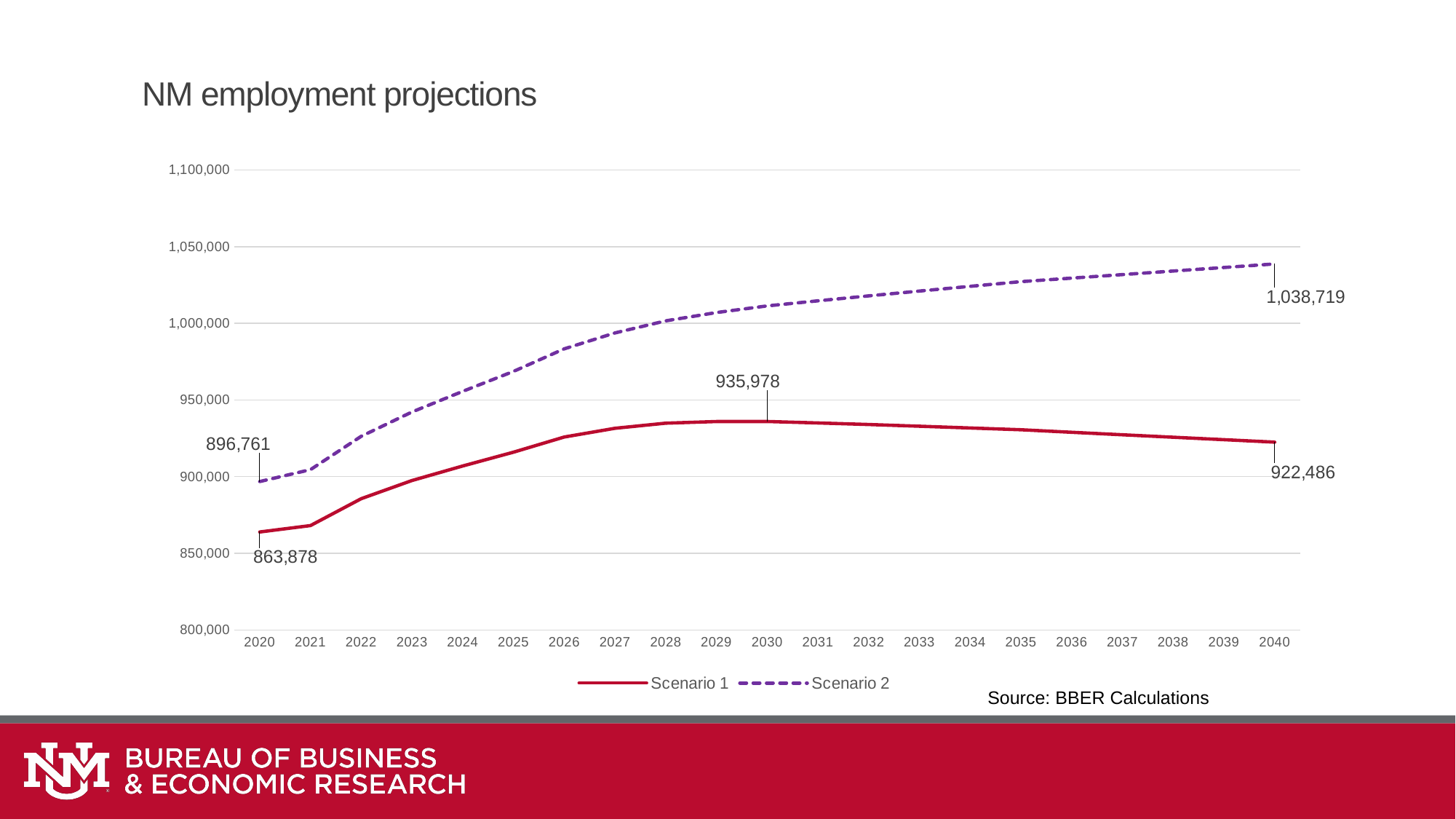
What is the value for Scenario 2 in 2020? 896,761 What is the difference between the Scenario 2 and Scenario 1 values in 2040? 116,233 What kind of chart is shown on the slide? Line chart Which scenario has the higher value in 2040? Scenario 2 What is the value for Scenario 1 in 2020? 863,878 How many series does the legend list? 2 Does Scenario 1 rise or fall between 2030 and 2040? Fall What is the value for Scenario 1 in 2040? 922,486 By how much does Scenario 1 change from 2020 to 2030? 72,100 What is the value for Scenario 1 in 2030? 935,978 What is the value for Scenario 2 in 2040? 1,038,719 Is the value for Scenario 2 in 2030 greater or less than 1,000,000? greater